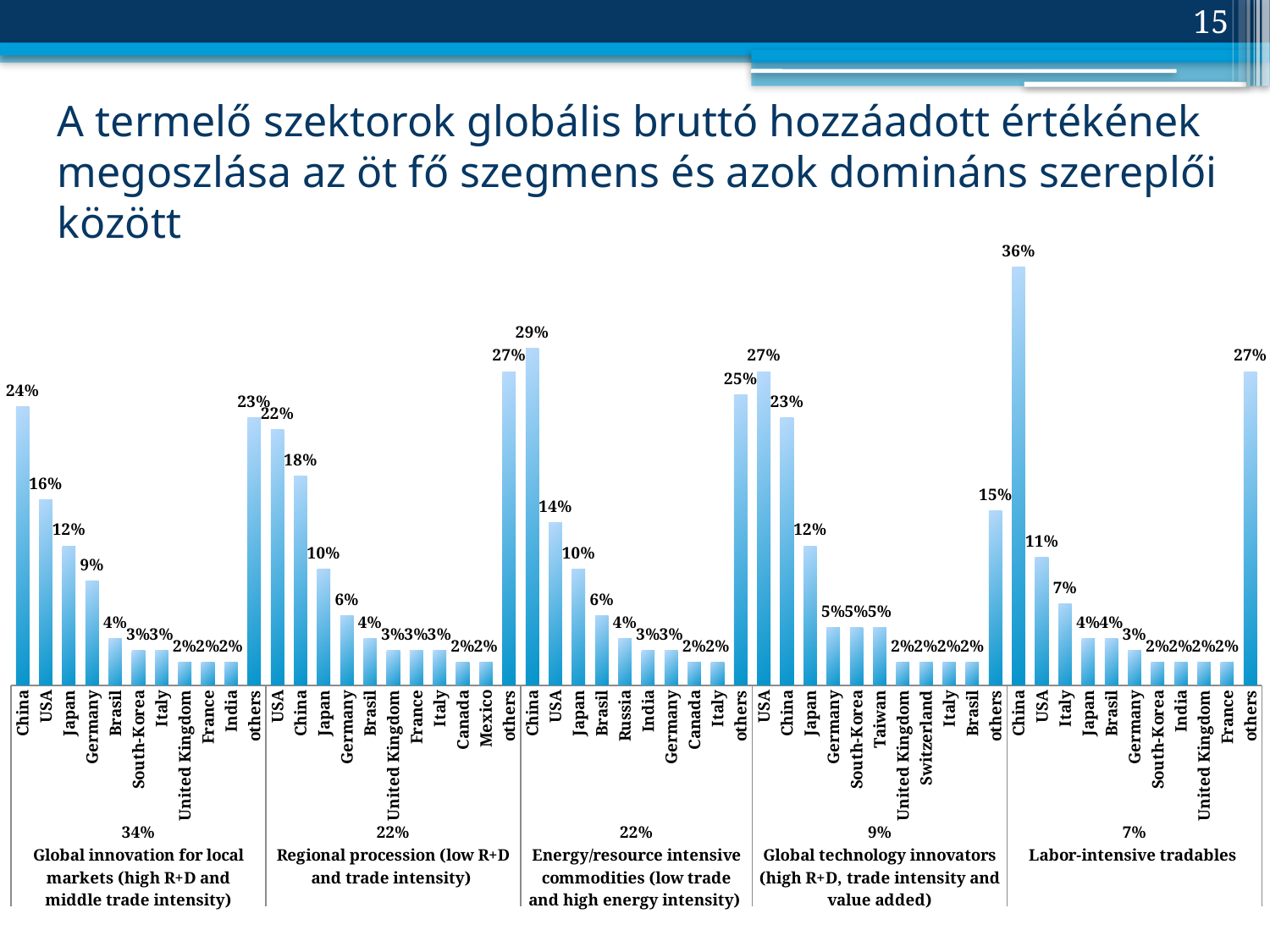
How many segments (groups) are shown along the x axis? 5 What is the value for China in the Global innovation for local markets segment? 24% Which is larger in the Global technology innovators segment, USA or China? USA What is the value for Taiwan in the Global technology innovators segment? 5% What is the value for Russia in the Energy/resource intensive commodities segment? 4% Which bar is the tallest in the whole chart? China in Labor-intensive tradables (36%) How many bars are shown in the Regional procession segment? 11 What kind of chart is shown on the slide? bar chart Which country has the highest value in the Labor-intensive tradables segment? China What share of global gross value added is shown for the Global innovation for local markets segment? 34% What is the value for USA in the Regional procession segment? 22% What is the difference between China and USA in the Energy/resource intensive commodities segment? 15%